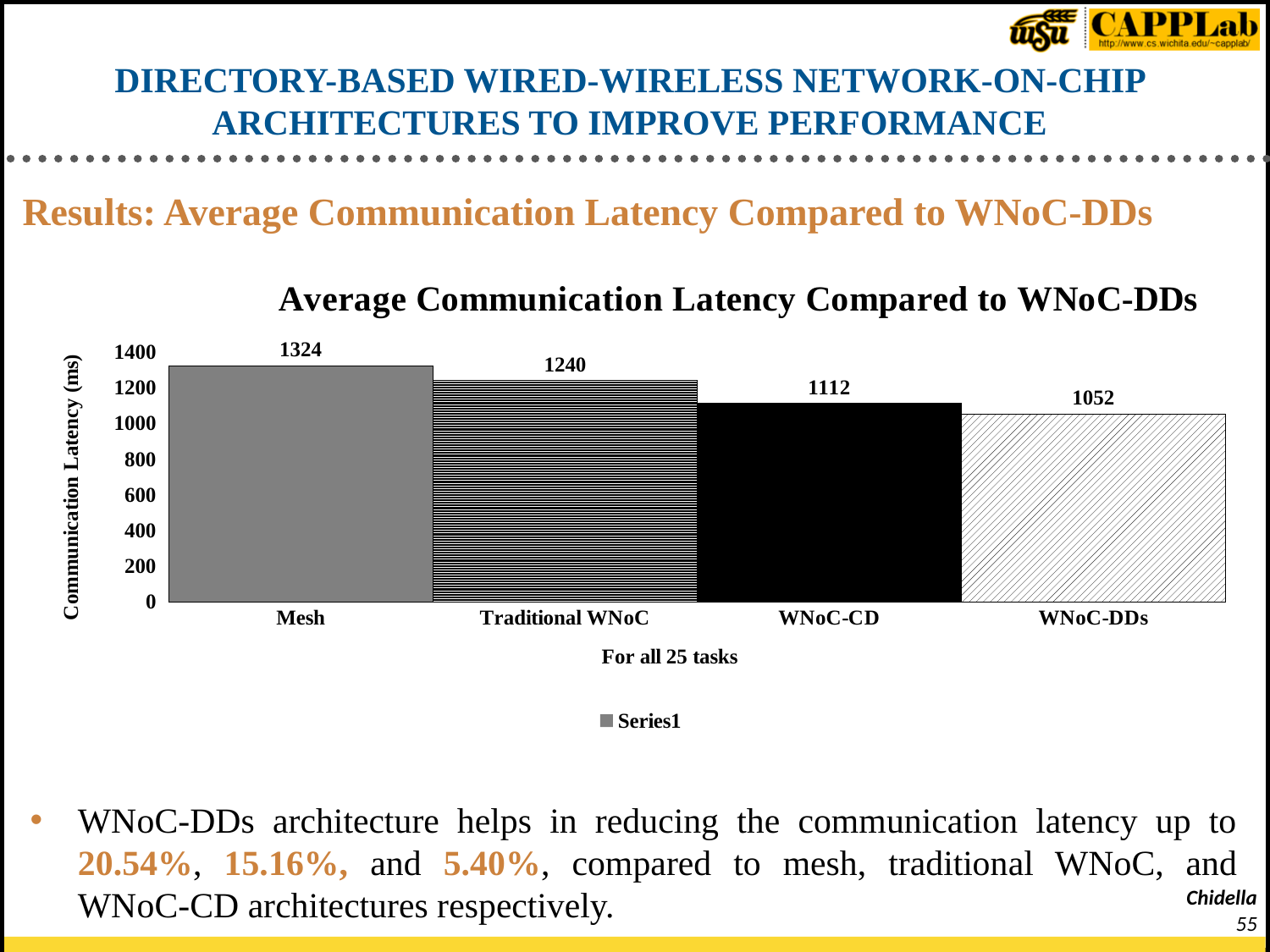
What is the difference in communication latency between Traditional WNoC and WNoC-CD? 128 What is the communication latency for WNoC-DDs? 1052 What type of chart is shown on the slide? Bar chart Which architecture has the lowest communication latency? WNoC-DDs Which has a higher communication latency, Traditional WNoC or WNoC-CD? Traditional WNoC What is the communication latency for WNoC-CD? 1112 Do the communication latency values rise or fall from left to right across the architectures? Fall What is the communication latency for Mesh? 1324 Which architecture has the highest communication latency? Mesh What is the difference in communication latency between Mesh and WNoC-DDs? 272 What is the communication latency for Traditional WNoC? 1240 How many architectures are shown on the chart? 4